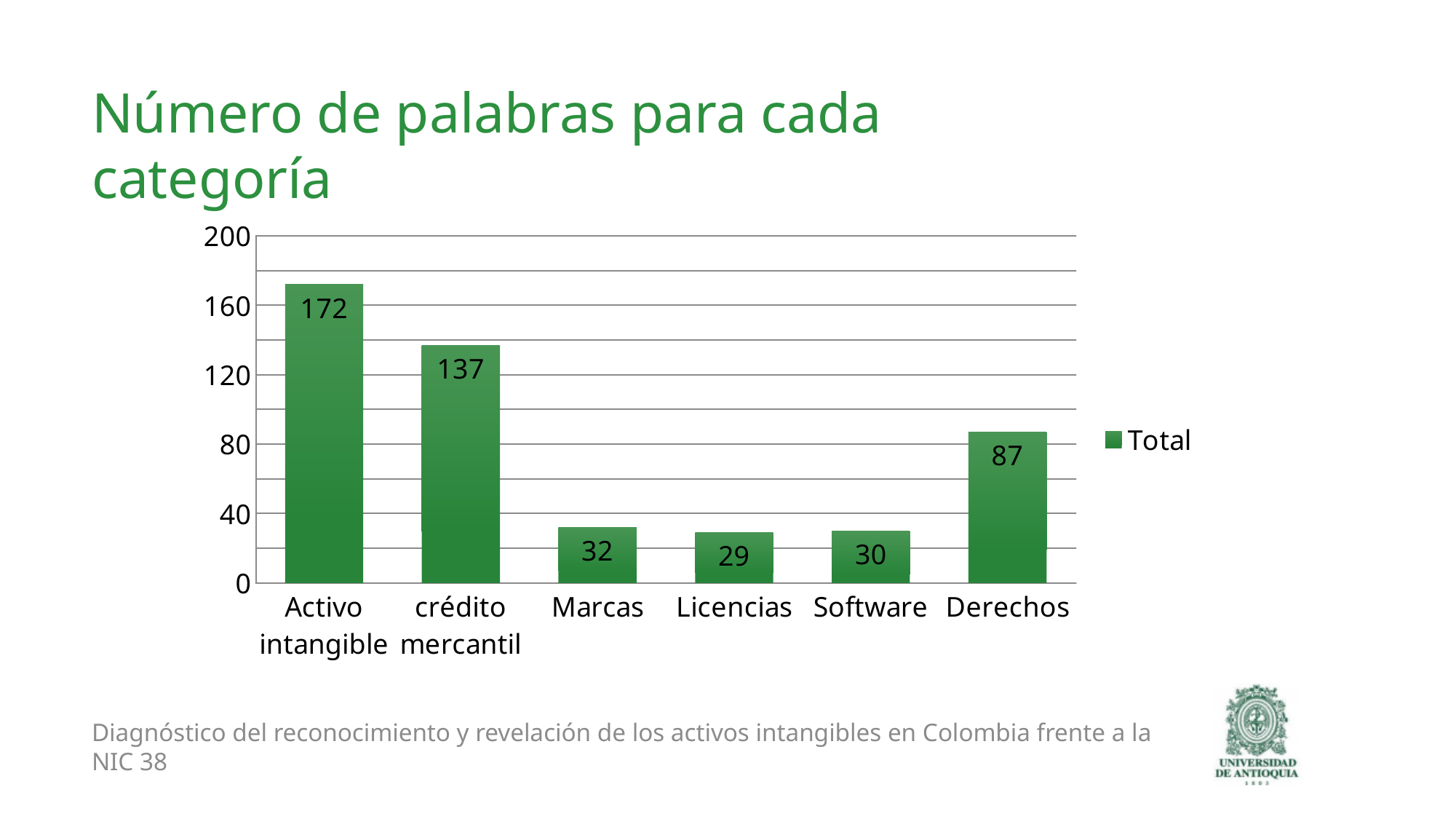
What kind of chart is shown on the slide? bar chart Is the value for Derechos greater or less than 80? greater How many categories are shown on the x axis? 6 Which is larger, the value for Marcas or the value for Software? Marcas What is the value for Licencias? 29 Which category has the lowest value? Licencias How many series does the legend list? 1 What is the value for Derechos? 87 What is the value for Activo intangible? 172 What is the difference between the values for Activo intangible and crédito mercantil? 35 Which category has the highest value? Activo intangible What is the value for crédito mercantil? 137